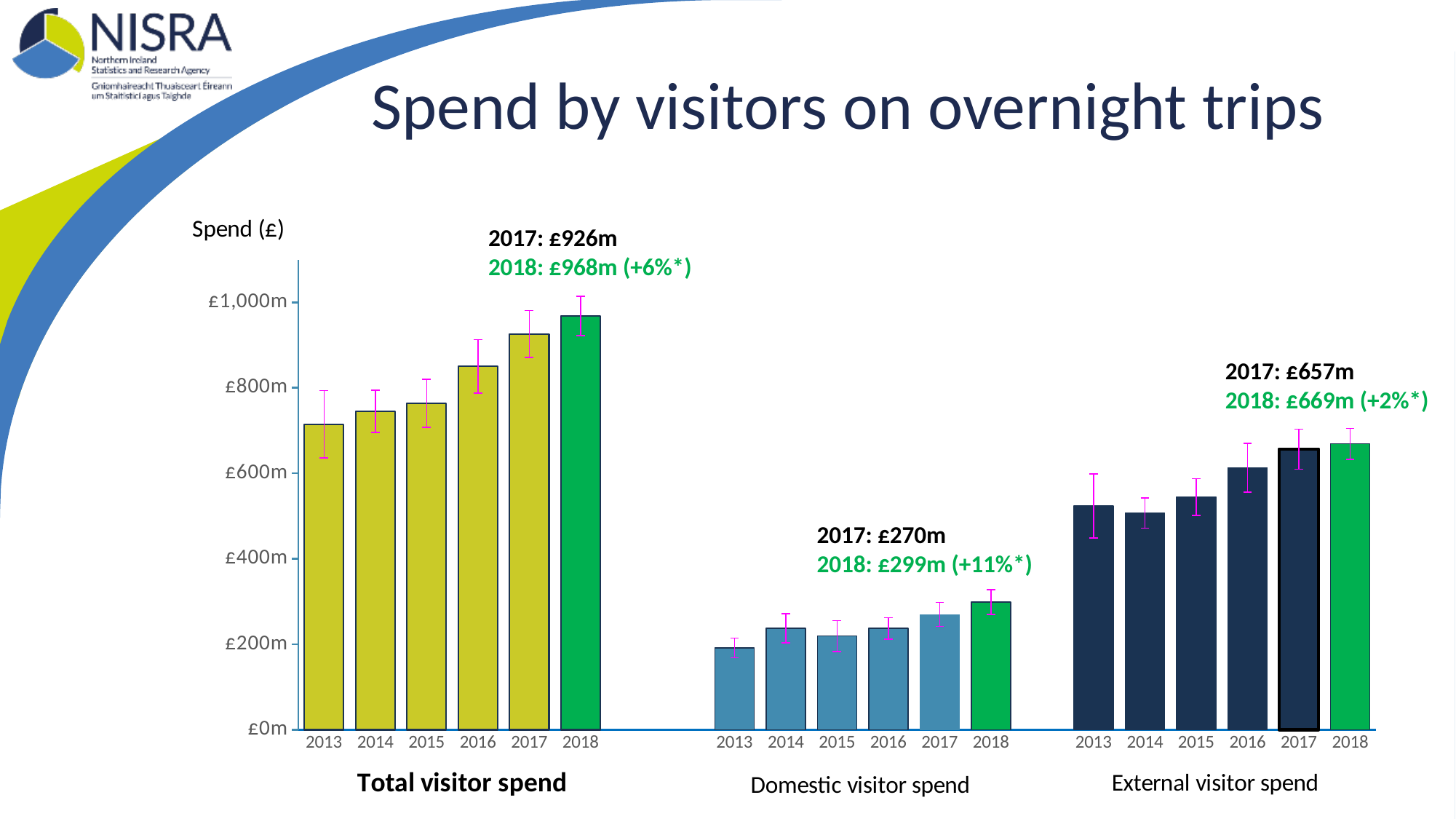
What was the total visitor spend in 2018? £968m By how much did total visitor spend increase from 2017 to 2018? £42m What kind of chart is shown on the slide? Bar chart How many years are shown for each visitor spend group? 6 Which year has the highest total visitor spend? 2018 Which is larger, the external visitor spend in 2017 or the domestic visitor spend in 2017? External visitor spend in 2017 What is the difference between domestic visitor spend in 2018 and 2017? £29m What was the external visitor spend in 2018? £669m Is the total visitor spend in 2013 greater or less than £800m? less Which year has the lowest domestic visitor spend? 2013 What was the domestic visitor spend in 2017? £270m Is the external visitor spend in 2016 greater or less than £600m? greater